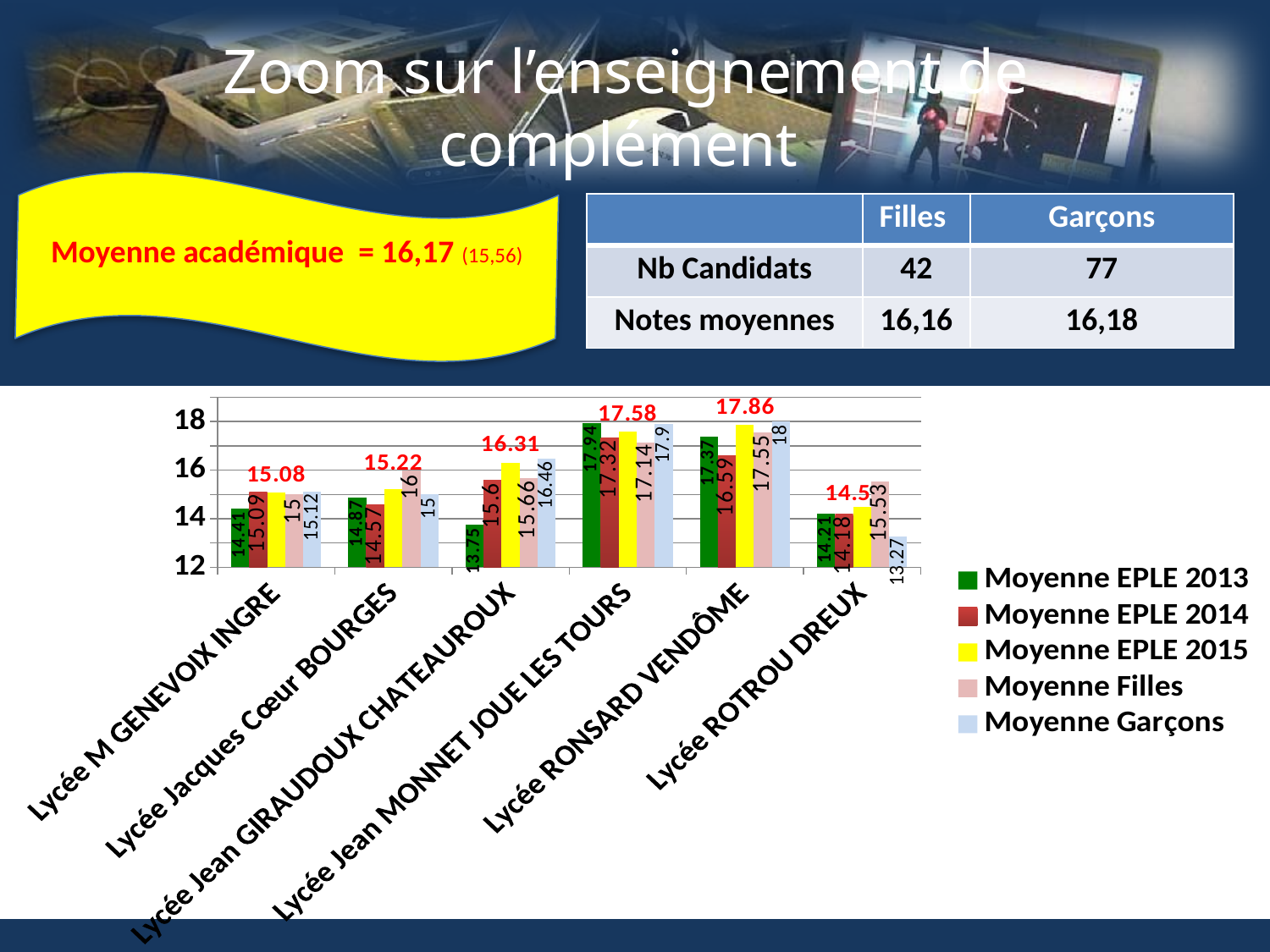
What is the Moyenne Garçons value for Lycée ROTROU DREUX? 13.27 How many lycées are shown on the x axis of the chart? 6 What kind of chart is shown on the slide? bar chart How many series does the chart legend list? 5 Which has the larger Moyenne EPLE 2013 value: Lycée Jean MONNET JOUE LES TOURS or Lycée RONSARD VENDÔME? Lycée Jean MONNET JOUE LES TOURS Which lycée has the highest Moyenne EPLE 2015 value? Lycée RONSARD VENDÔME What colour represents the Moyenne EPLE 2015 series in the chart? yellow What is the Moyenne Filles value for Lycée Jacques Cœur BOURGES? 16 By how much did the Moyenne EPLE value for Lycée Jean GIRAUDOUX CHATEAUROUX increase from 2014 to 2015? 0.71 Which lycée has the lowest Moyenne EPLE 2015 value? Lycée ROTROU DREUX What is the difference between the Moyenne Filles and Moyenne Garçons values for Lycée ROTROU DREUX? 2.26 What is the Moyenne EPLE 2015 value for Lycée RONSARD VENDÔME? 17.86